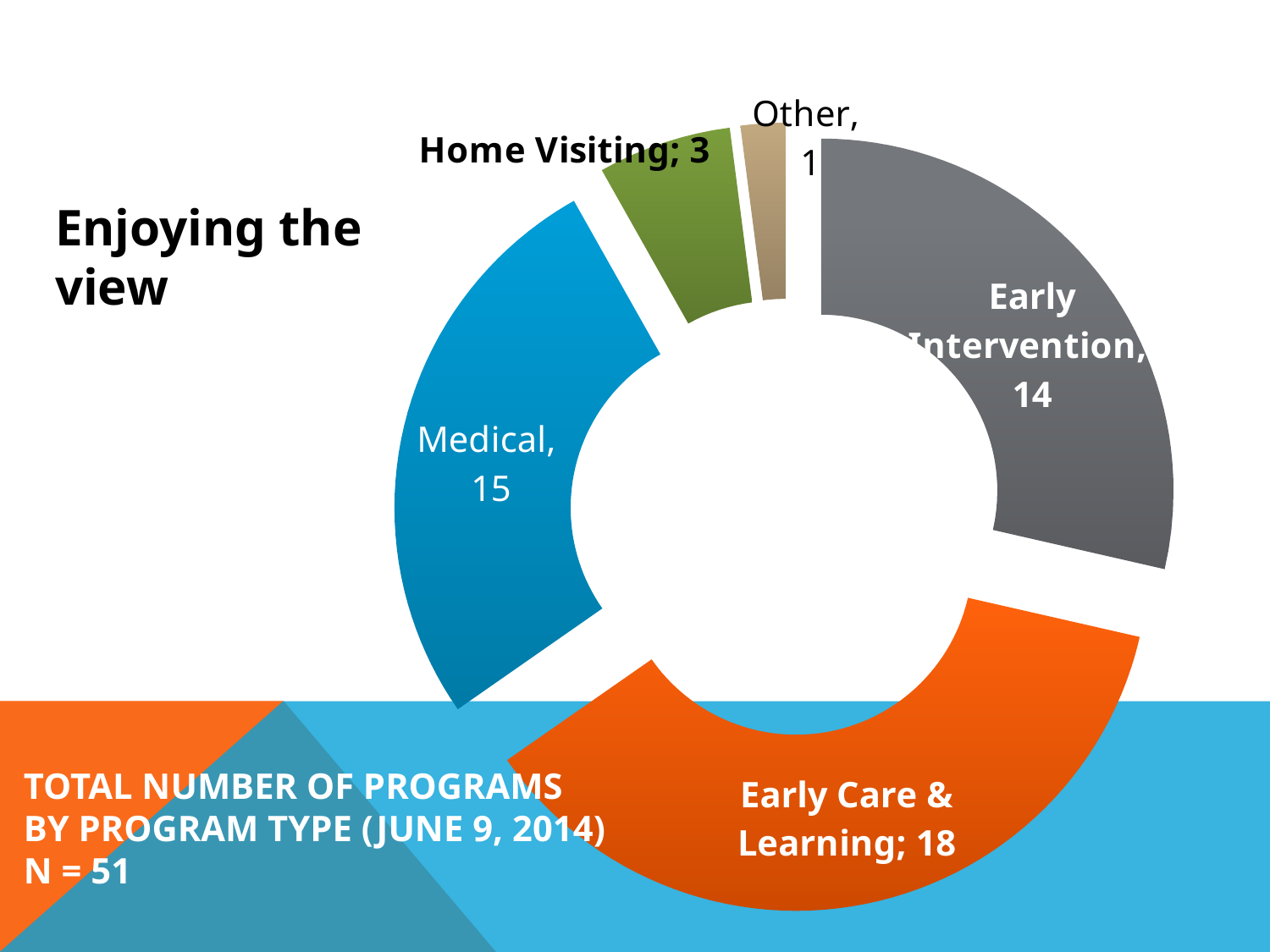
How many program type categories does the chart show? 5 Which program type has the largest number of programs? Early Care & Learning How many programs are in the Early Care & Learning category? 18 What kind of chart is shown on the slide? doughnut chart What is the difference between the Early Care & Learning and Medical values? 3 How many programs are in the Home Visiting category? 3 What is the value for the Other category? 1 What is the value for Early Intervention? 14 Which program type has the smallest number of programs? Other What is the value for Medical? 15 What total number of programs (N) does the chart caption state? N = 51